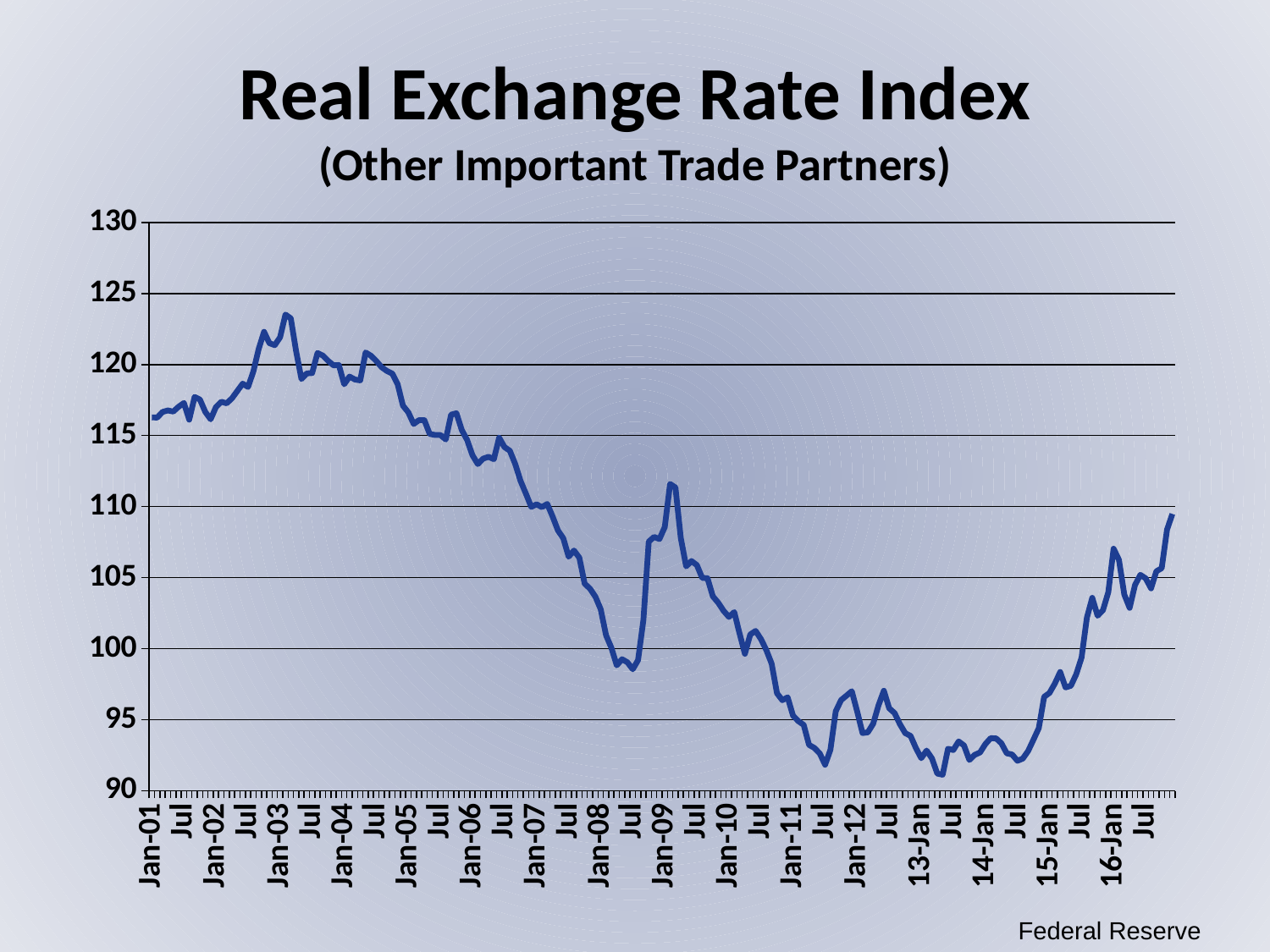
In which year does the index reach its lowest point? 2013 Is the value for Jan-03 greater or less than 120? greater What is the title of the chart on the slide? Real Exchange Rate Index (Other Important Trade Partners) Is the value for Jul-11 greater or less than 95? less Is the value for Jan-16 greater or less than 100? greater Does the index rise or fall between Jan-03 and Jul-08? fall Does the index rise or fall between Jul-13 and the end of the series? rise What kind of chart is shown on the slide? line chart What source is cited for the chart data? Federal Reserve How many lines (series) are plotted on the chart? 1